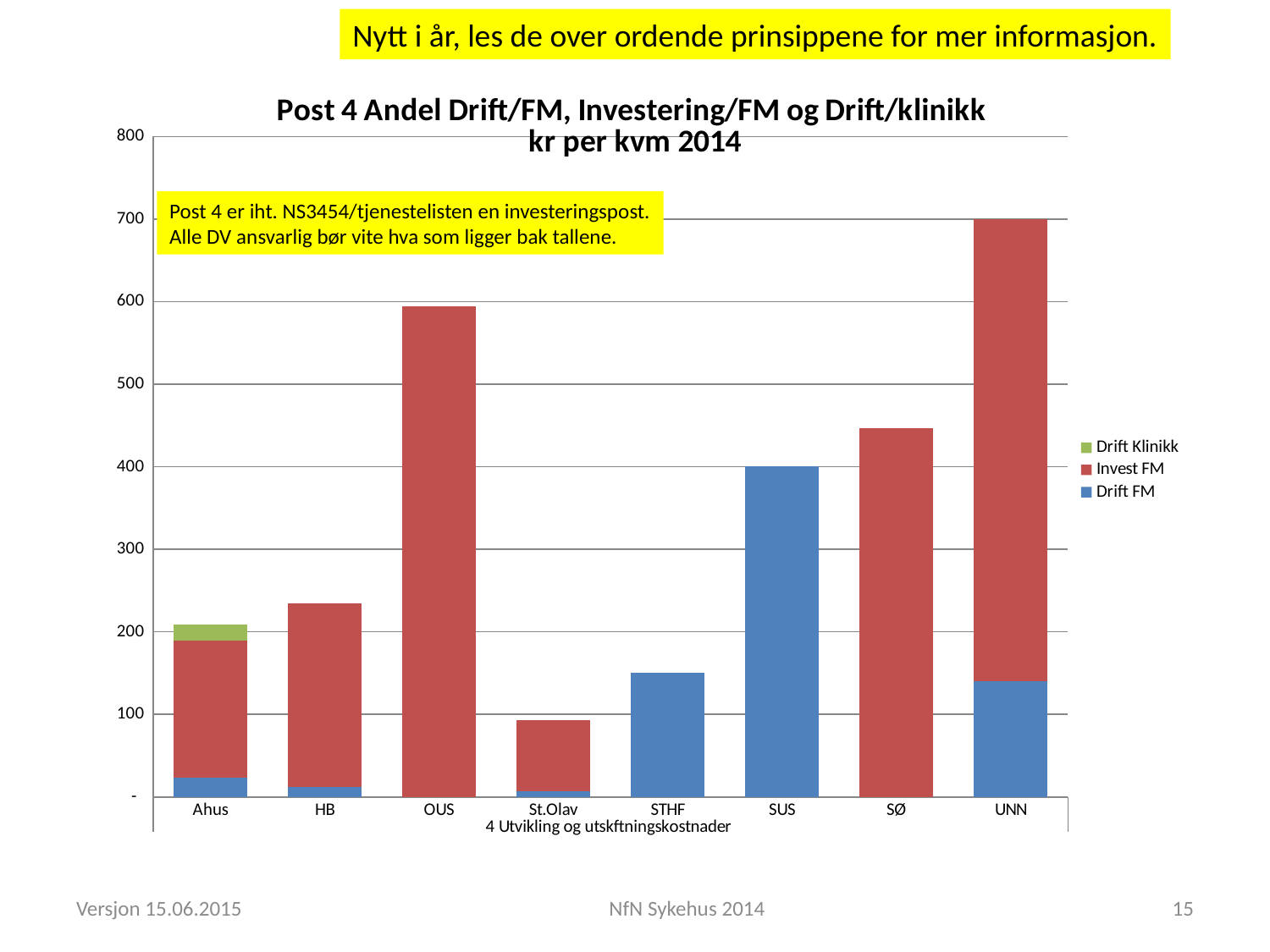
Which category has the shortest total bar in the chart? St.Olav How many series does the chart legend list? 3 Is the total value for OUS greater or less than 500? greater How many categories (hospitals) are shown on the x axis of the chart? 8 Is the total value for SØ greater or less than 400? greater Which category has the tallest total bar in the chart? UNN Which has the larger total bar, SUS or STHF? SUS Which has the larger total bar, OUS or SØ? OUS What kind of chart is shown on the slide? Stacked bar chart Is the total value for STHF greater or less than 200? less Which category is the only one with a Drift Klinikk (green) segment? Ahus